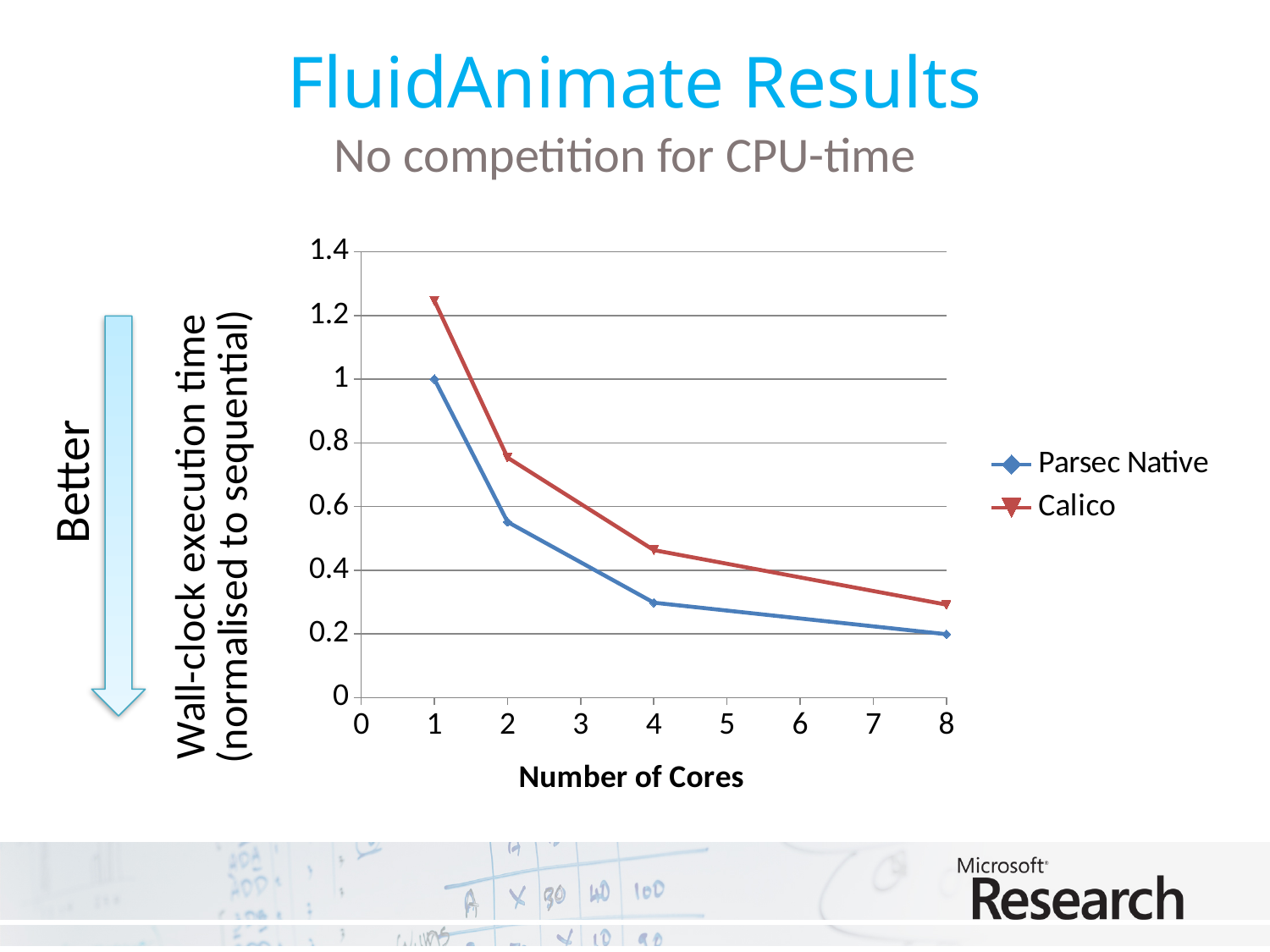
What is the title of the x axis? Number of Cores What kind of chart is shown on the slide? line chart Is the Calico value at 1 core greater or less than 1? greater Is the Calico value at 2 cores greater or less than 0.6? greater Is the Parsec Native value at 4 cores greater or less than 0.4? less Do the Calico values rise or fall as the number of cores increases? fall What is the Parsec Native value at 1 core? 1 How many data points are plotted for the Parsec Native series? 4 How many series does the legend list? 2 At 4 cores, which series has the higher value, Parsec Native or Calico? Calico Which series are listed in the legend? Parsec Native and Calico